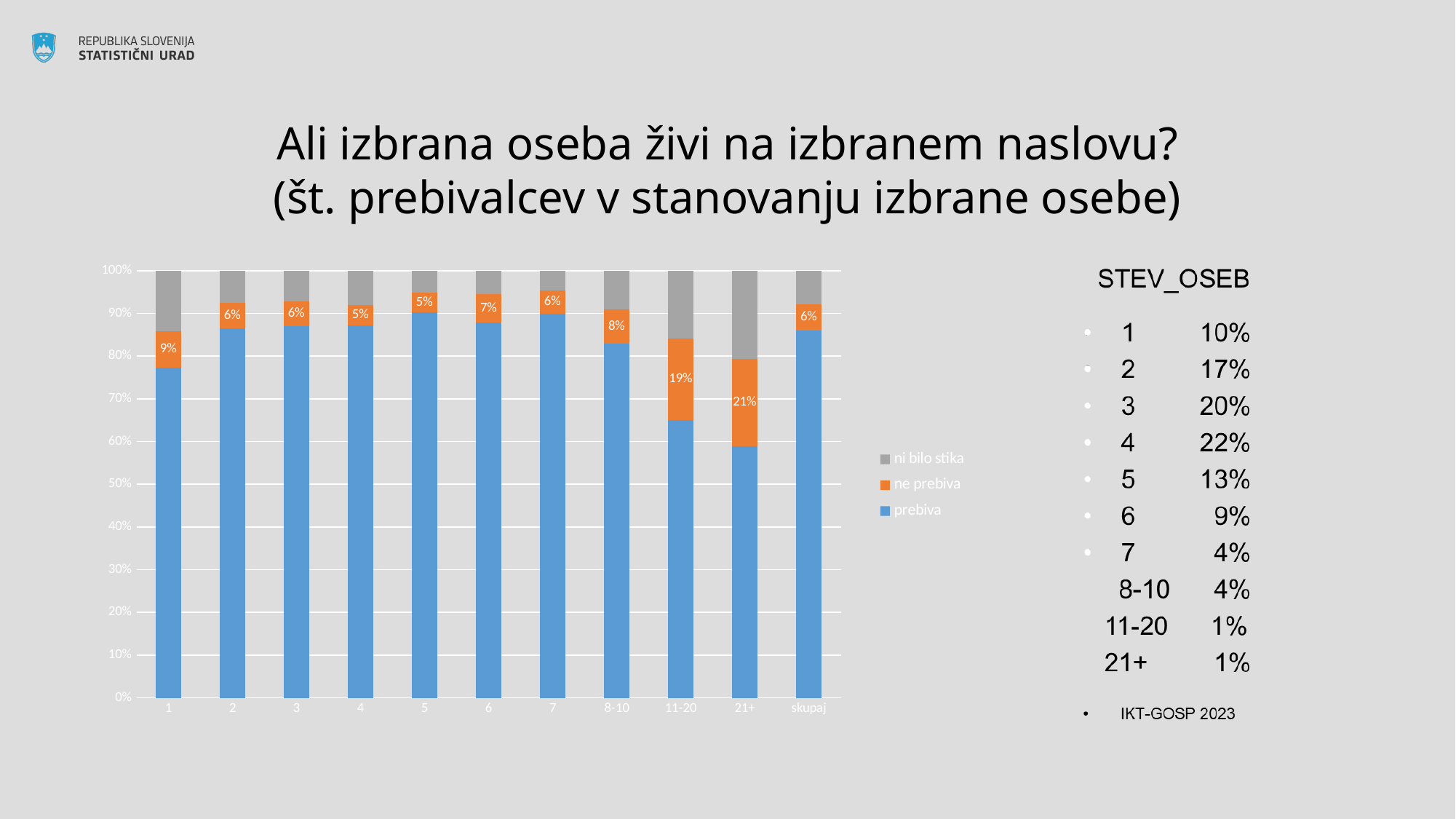
What is the difference between the "ne prebiva" percentages for "21+" and "11-20"? 2% What percentage is shown for "ne prebiva" in the "skupaj" category? 6% How many series does the chart legend list? 3 What percentage is shown for "ne prebiva" in the "1" category? 9% Is the "prebiva" value for category "21+" greater or less than 70%? less Is the "prebiva" value for category "11-20" greater or less than 60%? greater Which category has the highest "ne prebiva" percentage? 21+ Which has a larger "ne prebiva" percentage, category "1" or category "8-10"? 1 What percentage is shown for "ne prebiva" in the "11-20" category? 19% How many categories are shown on the x axis of the chart? 11 What kind of chart is shown on the slide? Stacked bar chart What percentage is shown for "ne prebiva" in the "21+" category? 21%